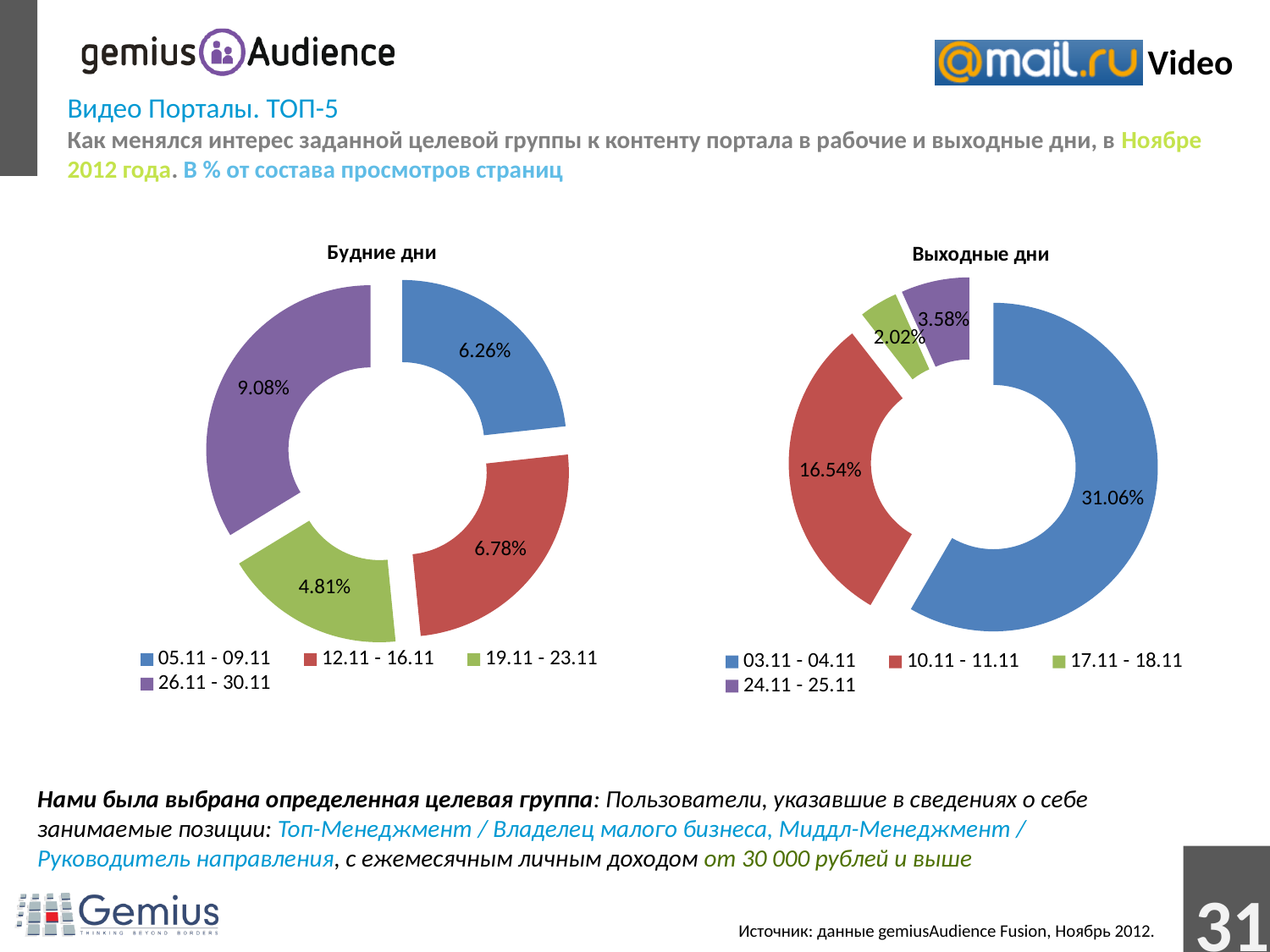
In the 'Выходные дни' chart, what is the value for 03.11 - 04.11? 31.06% In the 'Будние дни' chart, what colour is the slice for 26.11 - 30.11? purple In the 'Будние дни' chart, which period has the highest value? 26.11 - 30.11 How many periods are shown in the 'Выходные дни' chart? 4 In the 'Будние дни' chart, which is larger: the value for 05.11 - 09.11 or the value for 12.11 - 16.11? 12.11 - 16.11 In the 'Будние дни' chart, which period has the lowest value? 19.11 - 23.11 In the 'Выходные дни' chart, which period has the lowest value? 17.11 - 18.11 In the 'Будние дни' chart, what is the value for 19.11 - 23.11? 4.81% In the 'Будние дни' chart, what is the value for 26.11 - 30.11? 9.08% In the 'Выходные дни' chart, what is the value for 17.11 - 18.11? 2.02% What kind of chart is the 'Будние дни' chart? doughnut chart